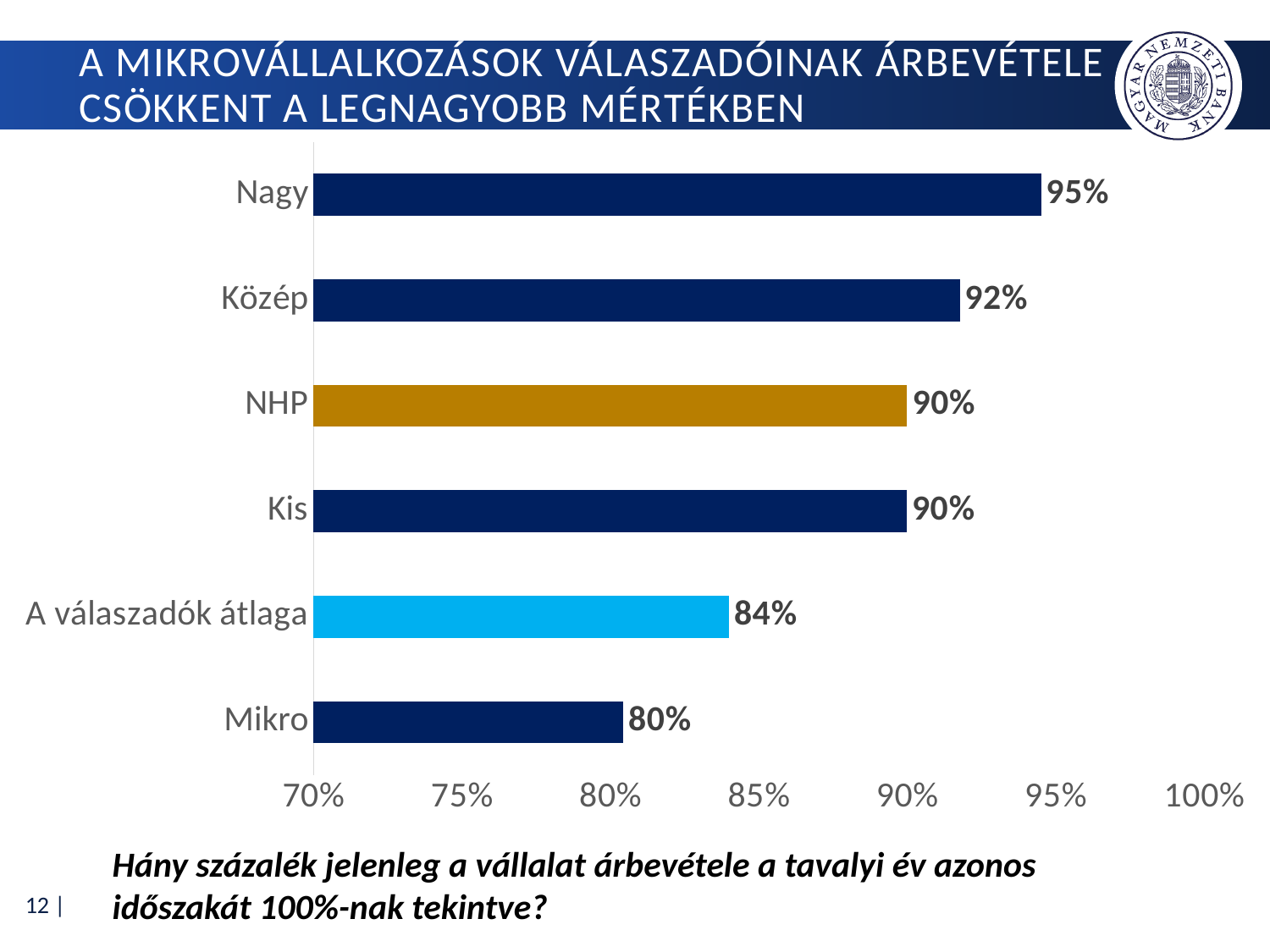
Which category has the highest value? Nagy What is the value for A válaszadók átlaga? 84% What is the difference between the values for Nagy and Mikro? 15% Is the value for Mikro greater or less than 85%? less What is the value for Nagy? 95% What is the value for NHP? 90% Which is larger, the value for Közép or the value for Kis? Közép Which category has the lowest value? Mikro How many categories are shown in the chart? 6 What is the difference between the values for Közép and A válaszadók átlaga? 8% What is the value for Mikro? 80% What kind of chart is shown on the slide? bar chart